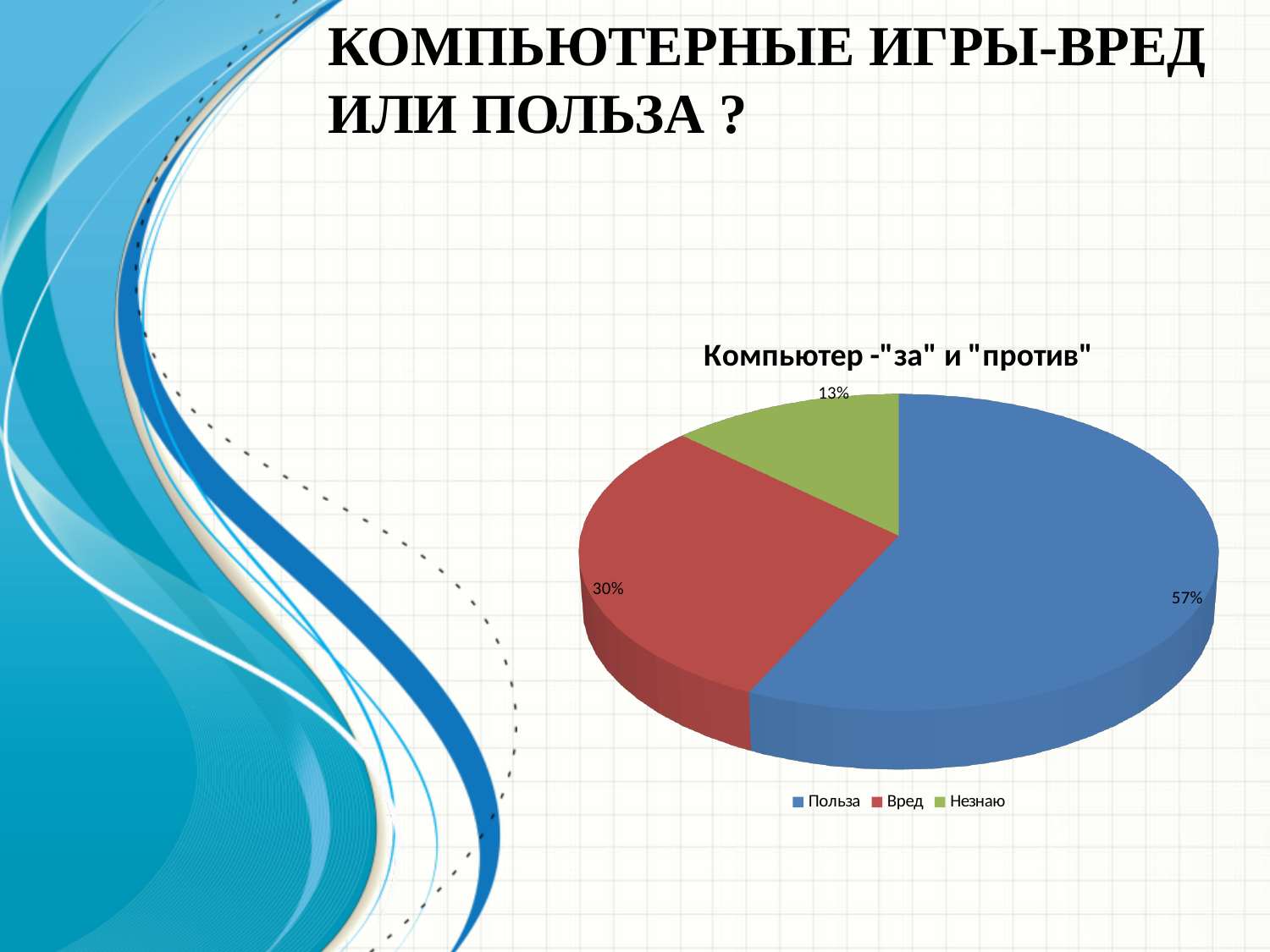
What is the difference in percentage points between Польза and Вред? 27 Which category has the largest slice of the pie? Польза What percentage of the pie is labelled for Незнаю? 13% What colour is the slice for Вред? red Which category has the smallest slice of the pie? Незнаю What type of chart is shown on the slide? pie chart What percentage of the pie is labelled for Вред? 30% Which is larger, the slice for Вред or the slice for Незнаю? Вред What percentage of the pie is labelled for Польза? 57% How many categories does the pie chart have? 3 What is the title of the chart? Компьютер -"за" и "против" What is the difference in percentage points between Вред and Незнаю? 17